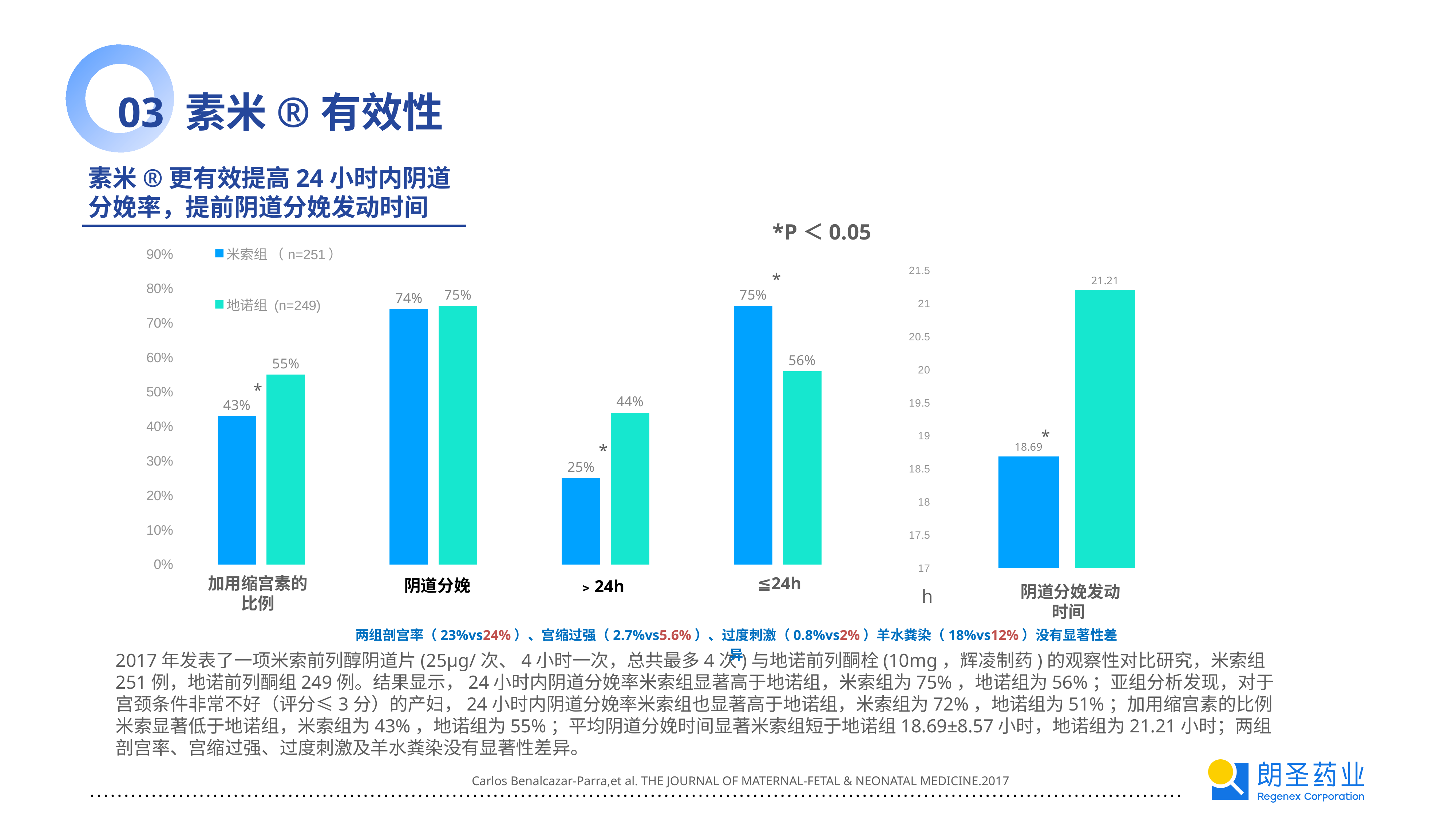
In the left chart, what is the value for 米索组 in the ≦24h category? 75% In the right chart (阴道分娩发动时间), what is the value for 地诺组? 21.21 In the left chart, what is the value for 地诺组 in the > 24h category? 44% In the left chart, what is the difference between 米索组 and 地诺组 in the ≦24h category? 19% In the left chart, what is the value for 米索组 in the 加用缩宫素的比例 category? 43% In the left chart, which is larger in the 加用缩宫素的比例 category, 米索组 or 地诺组? 地诺组 In the right chart (阴道分娩发动时间), what is the difference between 地诺组 and 米索组? 2.52 In the left chart, which category has the lowest value for 米索组? > 24h In the left chart, how many series does the legend list? 2 In the left chart, how many categories are shown on the x axis? 4 What kind of chart is the right chart (阴道分娩发动时间)? bar chart In the left chart, what is the sample size shown in the legend for 米索组? n=251